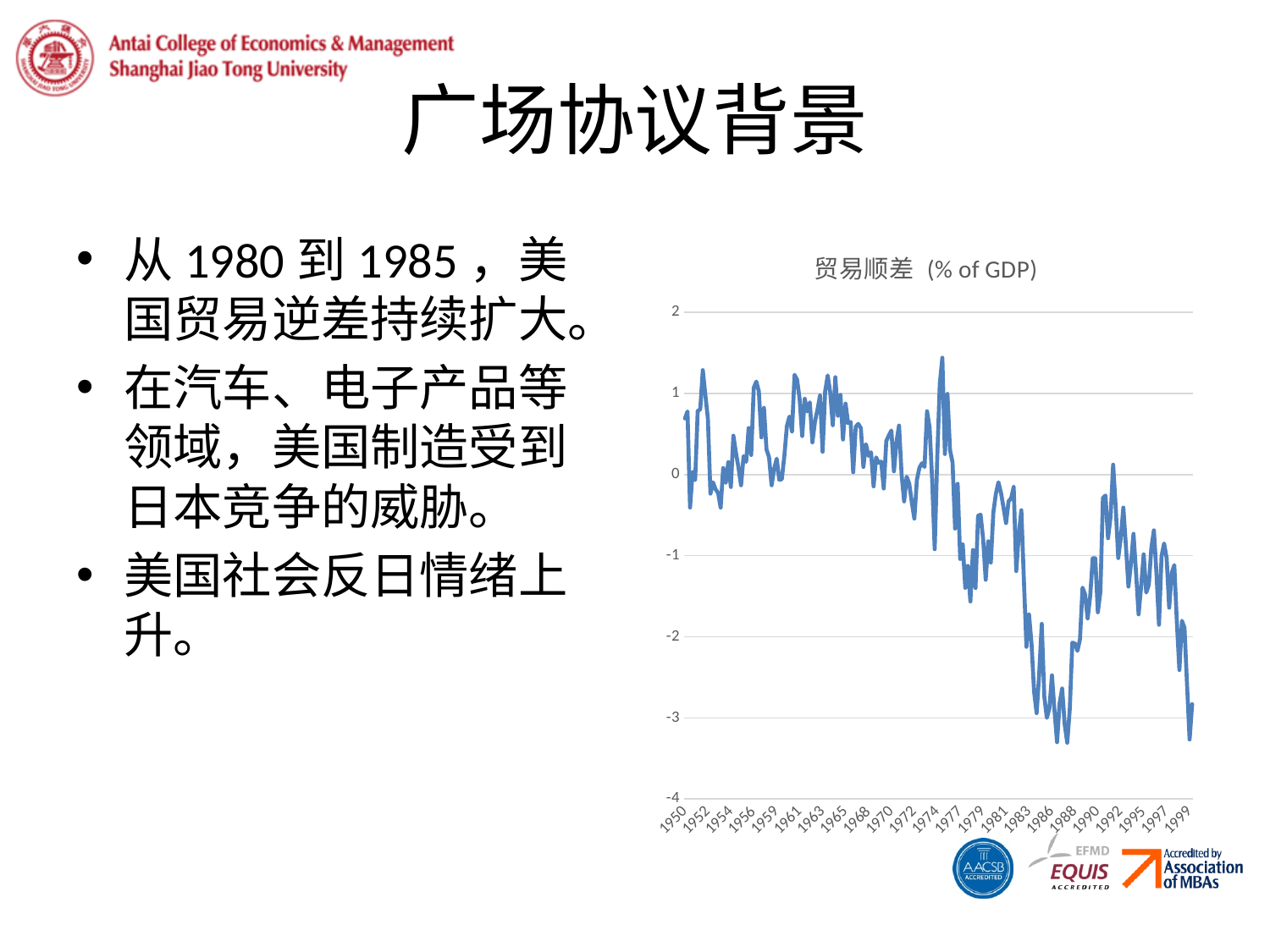
Is the value for 1979 greater or less than 0? less What kind of chart is shown on the slide? line chart Is the value for 1986 greater or less than -2? less Is the value for 1961 greater or less than 0? greater What is the highest value shown on the vertical axis? 2 What is the first year shown on the horizontal axis? 1950 Overall, do the values in the chart rise or fall from 1950 to 1999? fall What is the title of the chart? 贸易顺差 (% of GDP) What is the last year shown on the horizontal axis? 1999